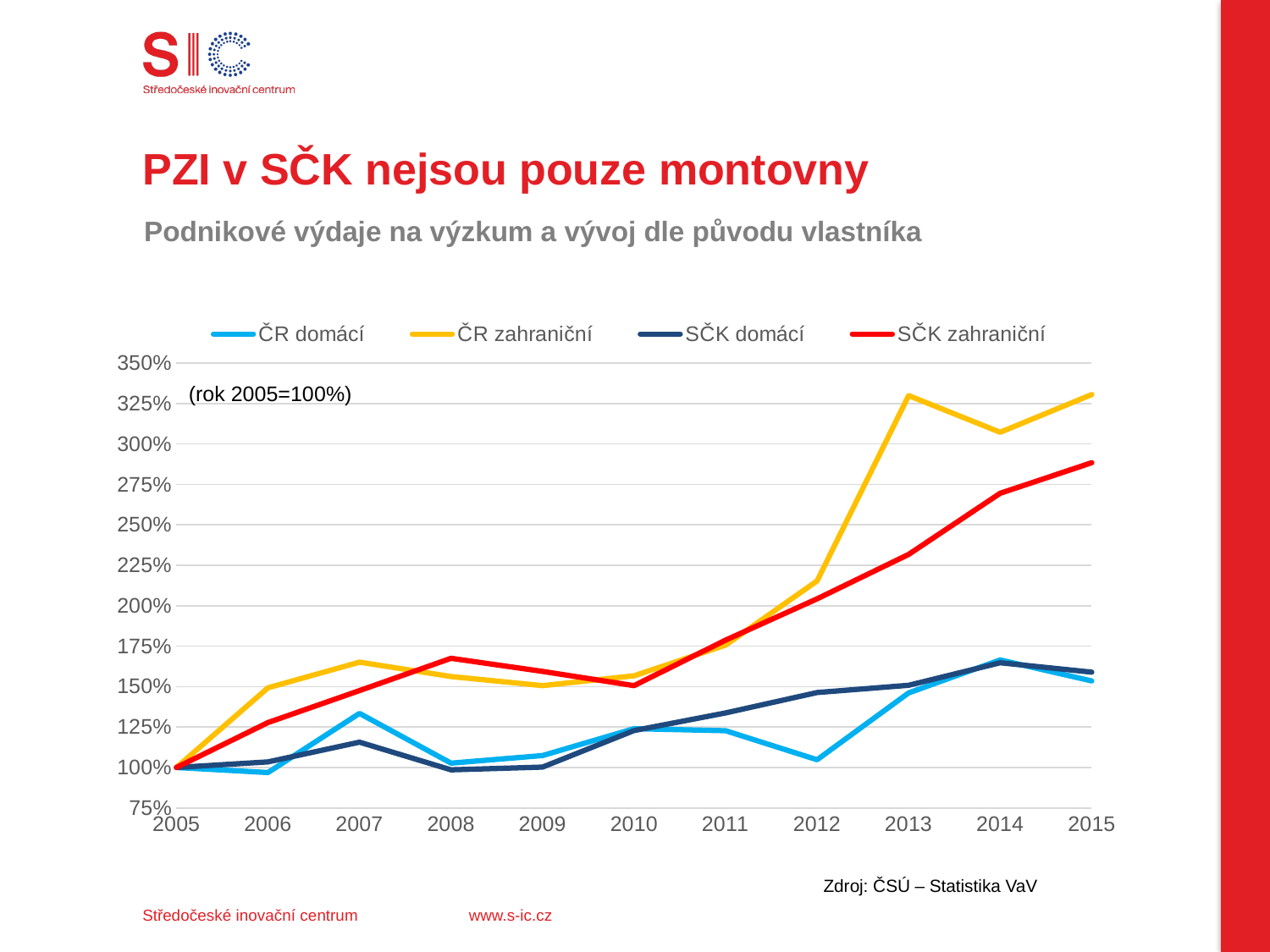
Is the value for ČR zahraniční in 2013 greater or less than 300%? greater Does the SČK zahraniční line rise or fall from 2010 to 2015? rise Is the value for SČK zahraniční in 2015 greater or less than 275%? greater How many years are shown along the x axis of the chart? 11 What colour is the SČK zahraniční line in the chart? red What kind of chart is shown on the slide? line chart What is the value of every series in 2005? 100% Is the value for ČR domácí in 2012 greater or less than 125%? less Which series has the lowest value in 2012? ČR domácí Which series has the highest value in 2015? ČR zahraniční How many series does the chart legend list? 4 In 2013, which is larger: ČR zahraniční or SČK zahraniční? ČR zahraniční